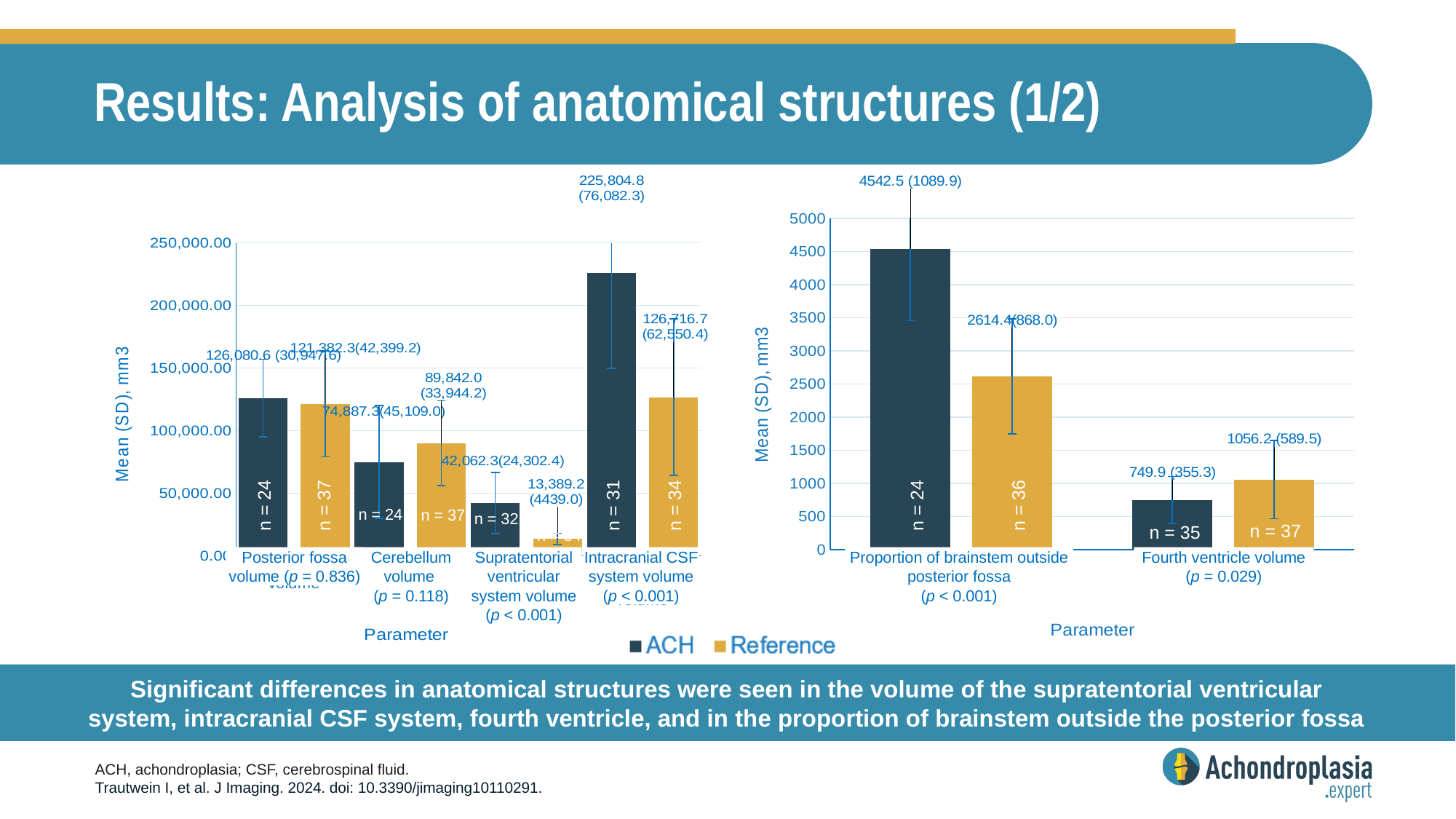
In the left chart, what is the mean value for the Reference group for Supratentorial ventricular system volume? 13,389.2 How many series does the legend list? 2 In the right chart, is the ACH mean value for Fourth ventricle volume greater or less than 1000? less In the right chart, what is the difference between the ACH and Reference mean values for Proportion of brainstem outside posterior fossa? 1928.1 In the right chart, what is the mean value for the Reference group for Fourth ventricle volume? 1056.2 In the left chart, which parameter has the lowest Reference mean value? Supratentorial ventricular system volume In the right chart, what is the SD shown for the Reference group for Proportion of brainstem outside posterior fossa? 868.0 In the right chart, what is the mean value for the ACH group for Proportion of brainstem outside posterior fossa? 4542.5 How many parameters are shown on the x axis of the left chart? 4 In the left chart, for Cerebellum volume, which group has the larger mean value, ACH or Reference? Reference In the left chart, which parameter has the highest ACH mean value? Intracranial CSF system volume In the left chart, what is the mean value for the ACH group for Intracranial CSF system volume? 225,804.8